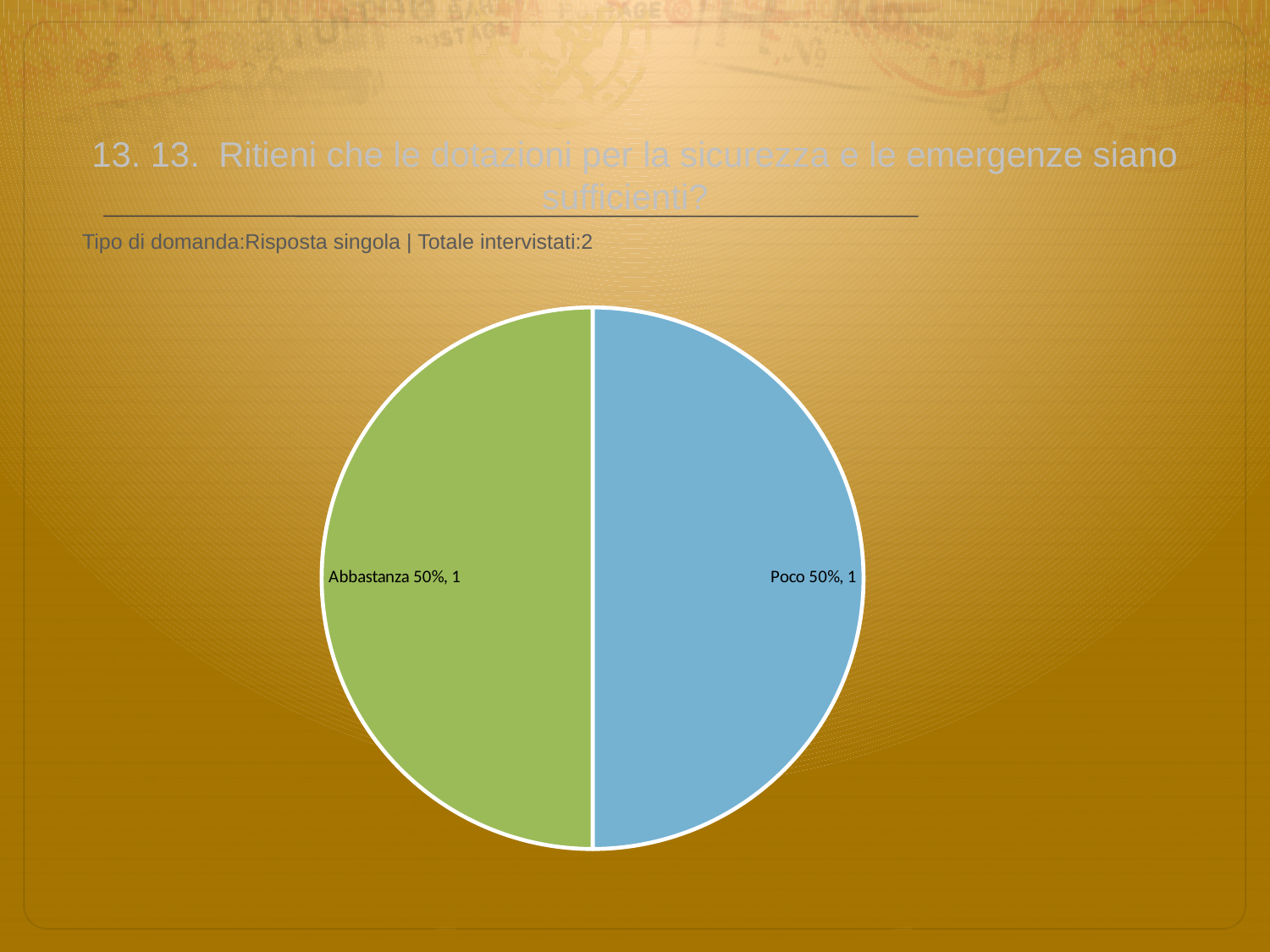
What kind of chart is shown on the slide? pie chart What share of the pie does the "Abbastanza" slice represent? 50% What is the total number of respondents across both slices? 2 What is the difference between the counts for "Poco" and "Abbastanza"? 0 What is the count shown for the "Poco" slice? 1 What is the count shown for the "Abbastanza" slice? 1 How many slices does the pie chart have? 2 What share of the pie does the "Poco" slice represent? 50% Which colour is the "Poco" slice? blue Which colour is the "Abbastanza" slice? green